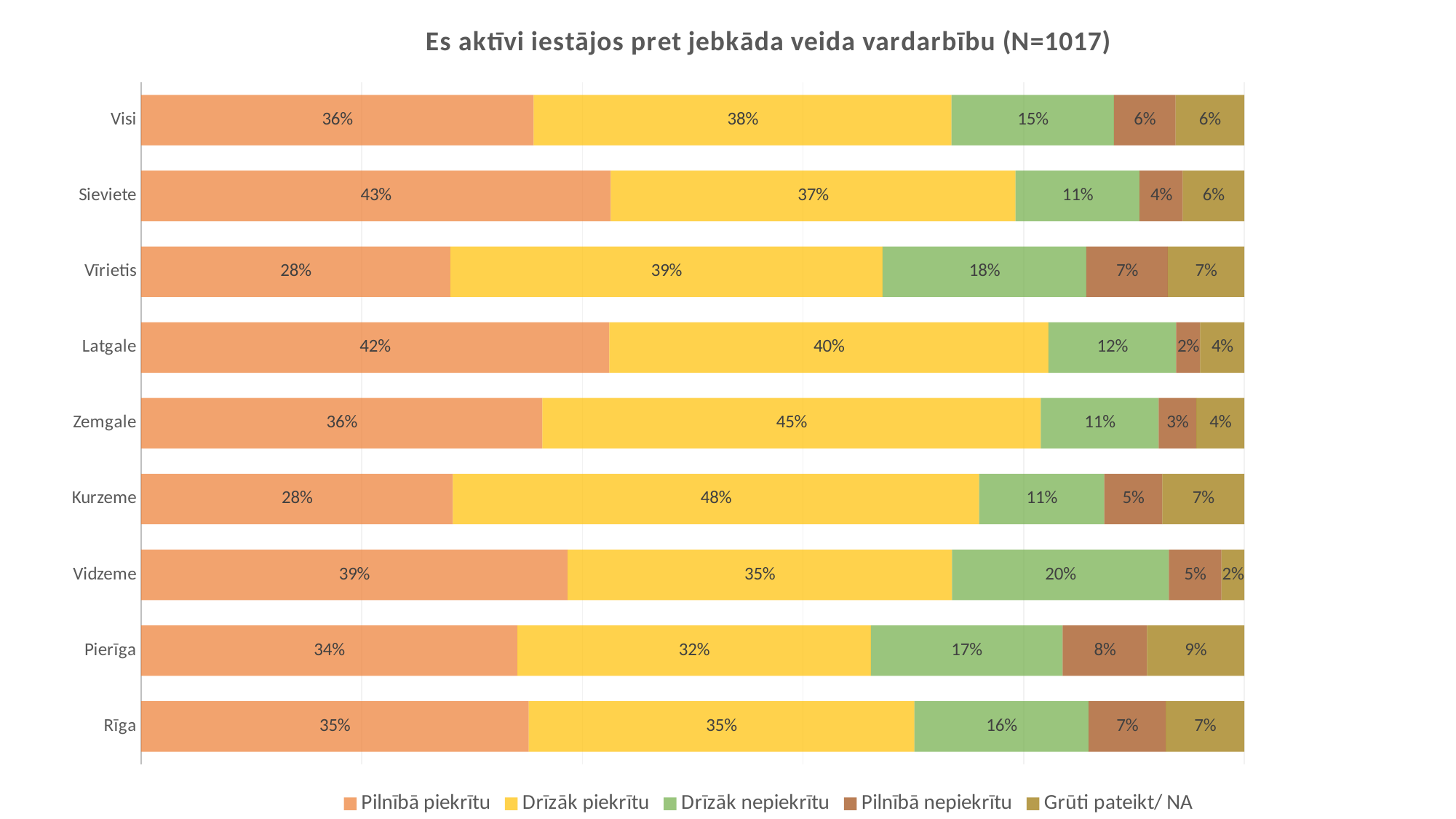
What is the difference in percentage points between the "Pilnībā piekrītu" values for Sieviete and Vīrietis? 15 What is the value of "Grūti pateikt/ NA" for Pierīga? 9% How many categories (bars) are shown on the chart? 9 Which has a larger "Drīzāk nepiekrītu" value, Vidzeme or Rīga? Vidzeme What is the value of "Pilnībā piekrītu" for Sieviete? 43% What kind of chart is shown on the slide? Stacked bar chart How many series does the legend list? 5 Which category has the lowest value for "Pilnībā nepiekrītu"? Latgale Which category has the highest value for "Drīzāk piekrītu"? Kurzeme What is the value of "Drīzāk nepiekrītu" for Vidzeme? 20% What is the title of the chart? Es aktīvi iestājos pret jebkāda veida vardarbību (N=1017) What is the value of "Drīzāk piekrītu" for Kurzeme? 48%